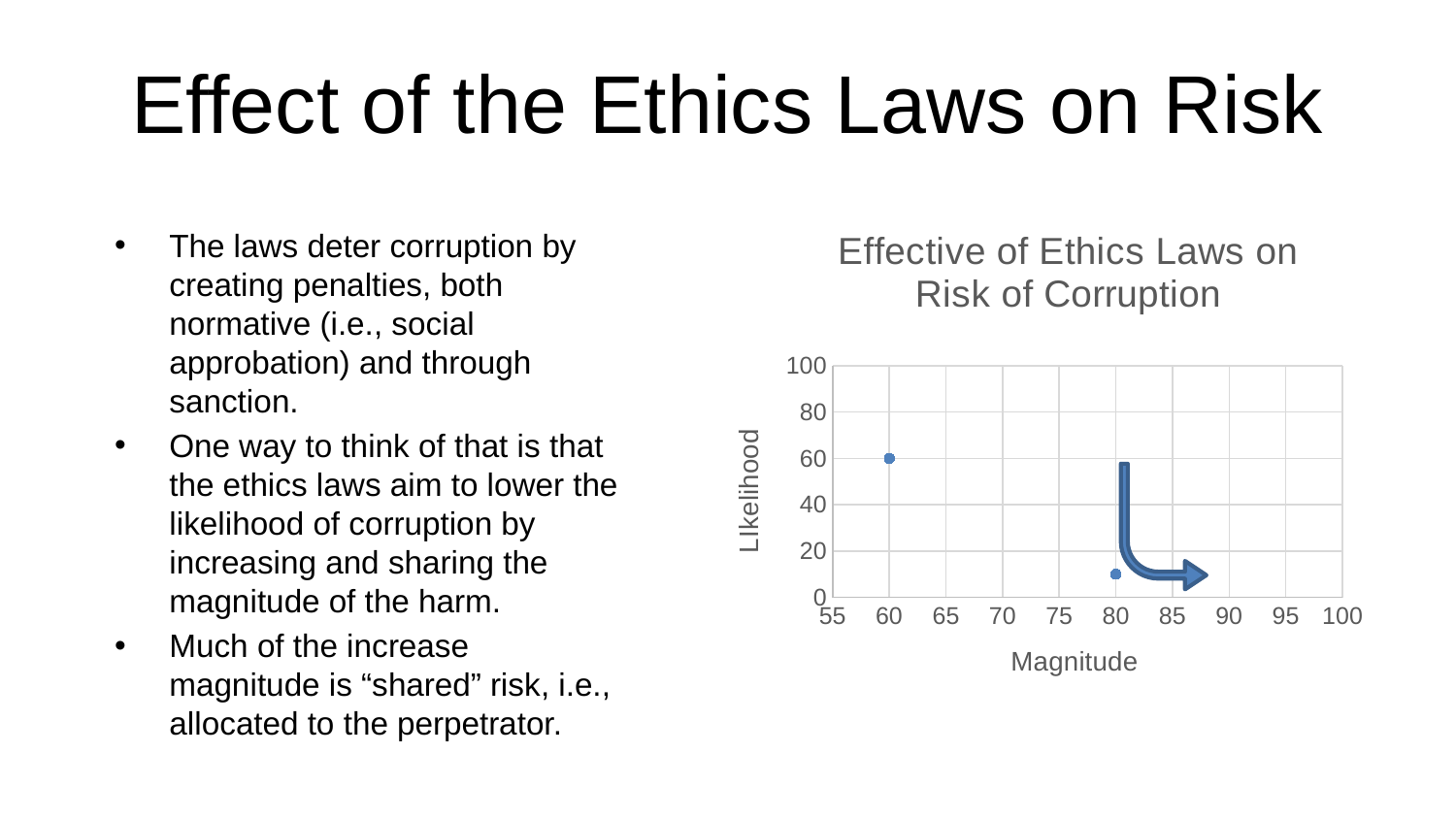
What is the Magnitude value of the point with the lowest Likelihood? 80 What is the Magnitude value of the point with the higher Likelihood? 60 What is the title of the chart? Effective of Ethics Laws on Risk of Corruption Does Likelihood rise or fall as Magnitude increases from 60 to 80? falls Is the Likelihood of the point at Magnitude 60 greater or less than 40? greater What is the Likelihood value of the point plotted at Magnitude 60? 60 Is the Likelihood of the point at Magnitude 80 greater or less than 20? less What is the label of the horizontal axis of the chart? Magnitude How many data points are plotted on the chart? 2 What kind of chart is shown on the slide? scatter chart Which point has the higher Likelihood, the one at Magnitude 60 or the one at Magnitude 80? the one at Magnitude 60